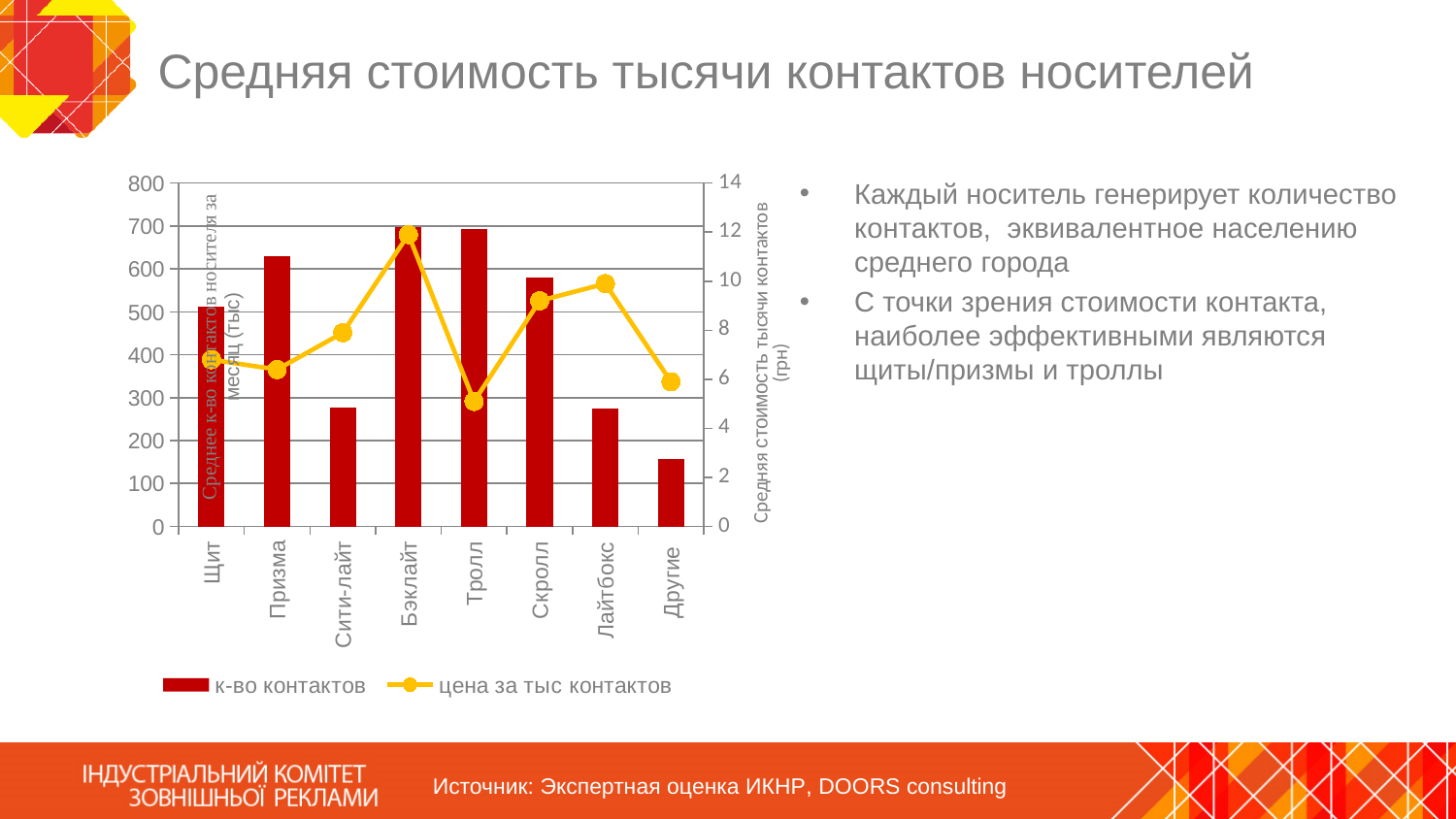
Is the к-во контактов bar for Другие greater or less than 200? less How many series does the chart legend list? 2 Which category has the lowest value on the цена за тыс контактов line? Тролл Is the к-во контактов bar for Призма greater or less than 600? greater Which category has the highest value on the цена за тыс контактов line? Бэклайт Is the цена за тыс контактов value for Тролл greater or less than 6? less Which category has the lowest bar for к-во контактов? Другие Which has the larger к-во контактов bar, Щит or Призма? Призма What are the two entries in the chart legend? к-во контактов and цена за тыс контактов How many categories are shown on the x axis of the chart? 8 What kind of chart is shown on the slide? A combination bar and line chart